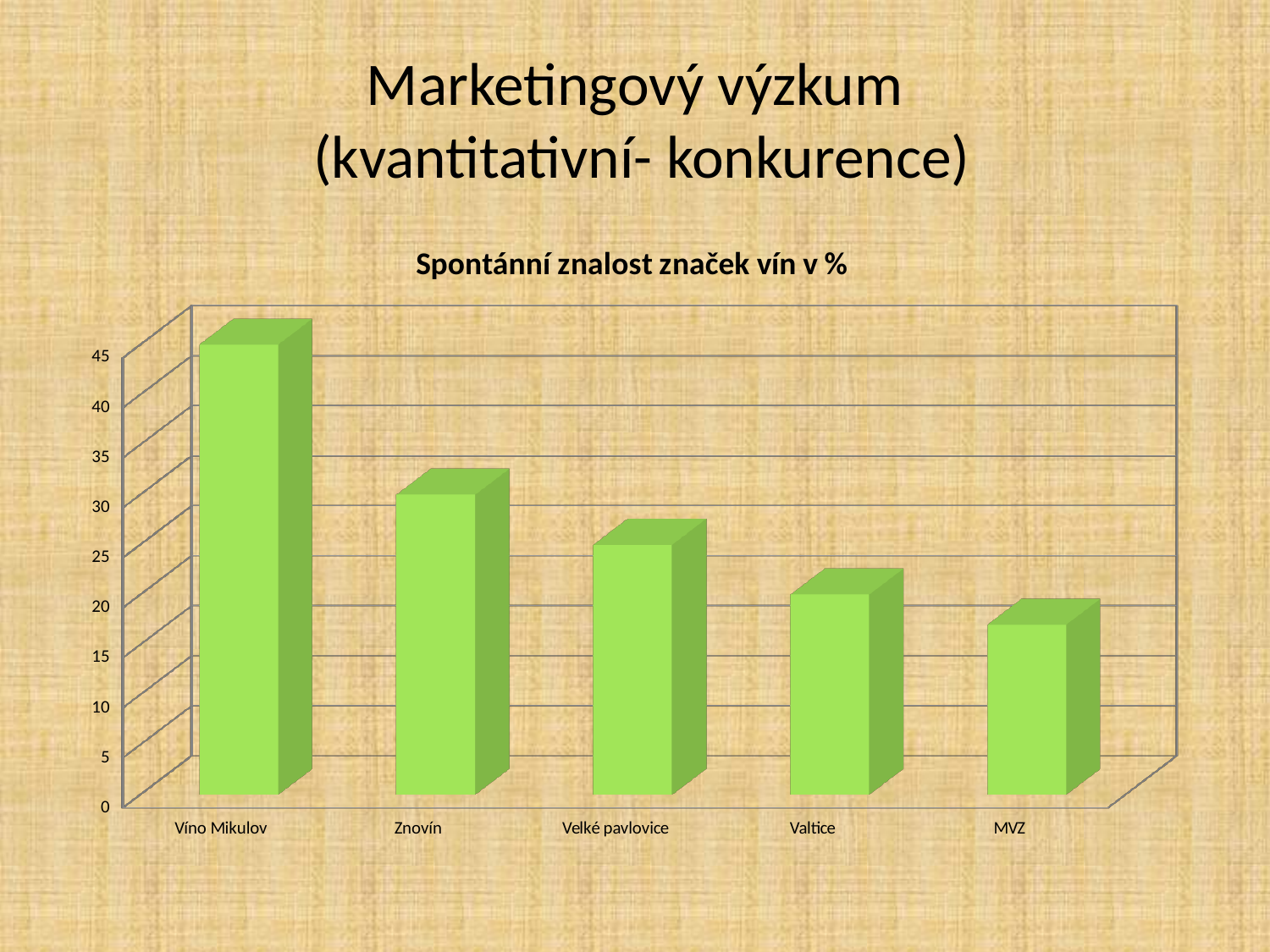
Which has a higher value, Znovín or Valtice? Znovín Is the value for Znovín greater or less than 25? greater Which brand has the lowest spontaneous brand awareness in the chart? MVZ How many wine brands are shown on the x axis of the chart? 5 What is the title of the chart? Spontánní znalost značek vín v % What kind of chart is shown on the slide? bar chart Is the value for Víno Mikulov greater or less than 40? greater Which brand has the highest spontaneous brand awareness in the chart? Víno Mikulov Is the value for Velké pavlovice greater or less than 30? less Do the values rise or fall moving from left to right along the x axis? fall